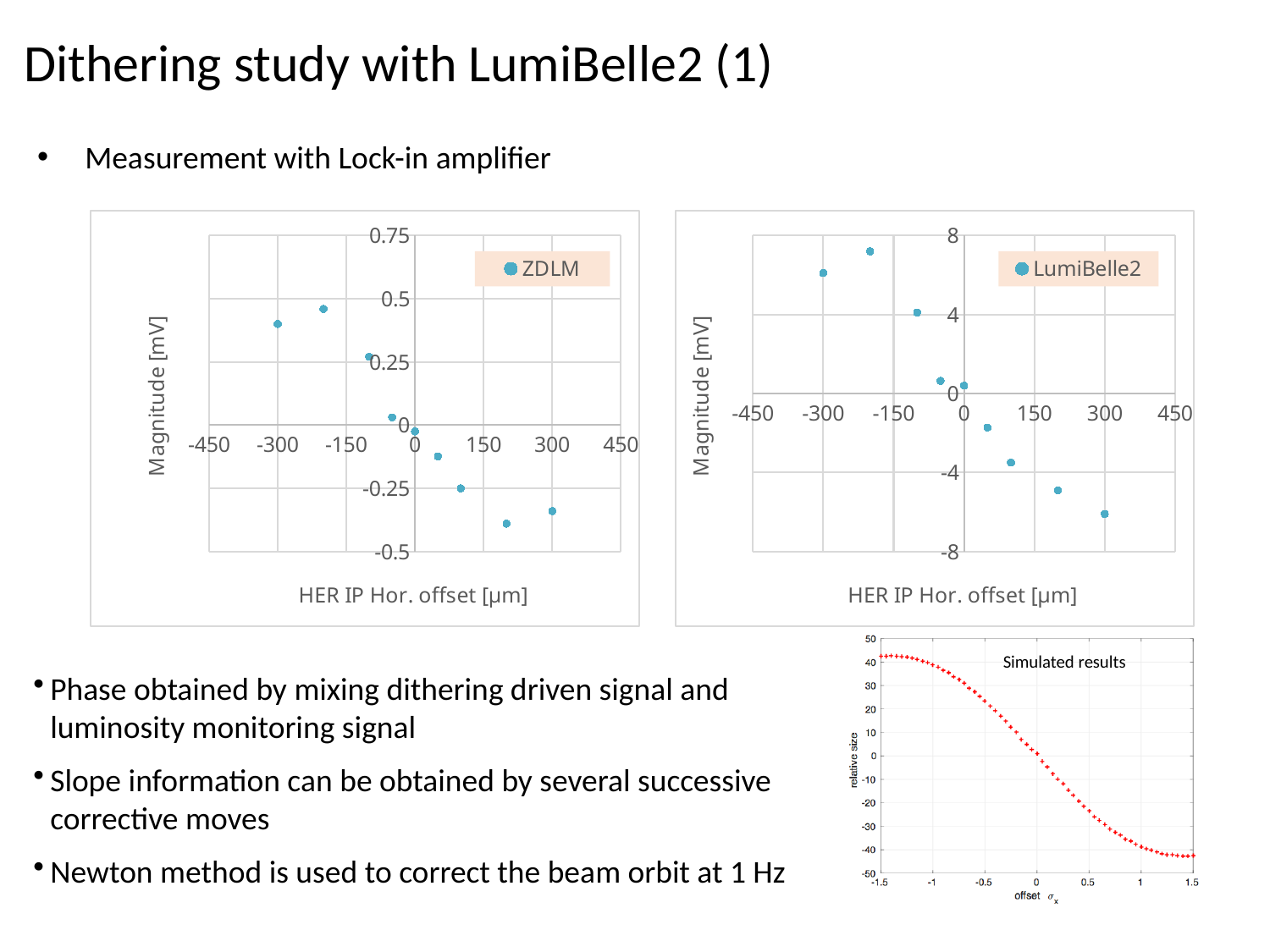
How many series does the legend of the LumiBelle2 chart list? 1 What is the legend entry of the chart on the left? ZDLM In the LumiBelle2 chart, is the magnitude at an offset of -200 µm greater or less than 4 mV? greater In the ZDLM chart, do the magnitude values rise or fall as the HER IP horizontal offset increases? fall In the LumiBelle2 chart, do the magnitude values rise or fall as the HER IP horizontal offset increases? fall In the LumiBelle2 chart, which has the larger magnitude: the point at -300 µm or the point at 300 µm? -300 µm In the ZDLM chart, is the magnitude at an offset of -300 µm greater or less than 0.25 mV? greater In the LumiBelle2 chart, at which HER IP horizontal offset is the magnitude highest? -200 µm What is the y-axis title of the LumiBelle2 chart? Magnitude [mV] In the LumiBelle2 chart, is the magnitude at an offset of 300 µm greater or less than -4 mV? less What kind of chart is the ZDLM chart on the left? scatter chart